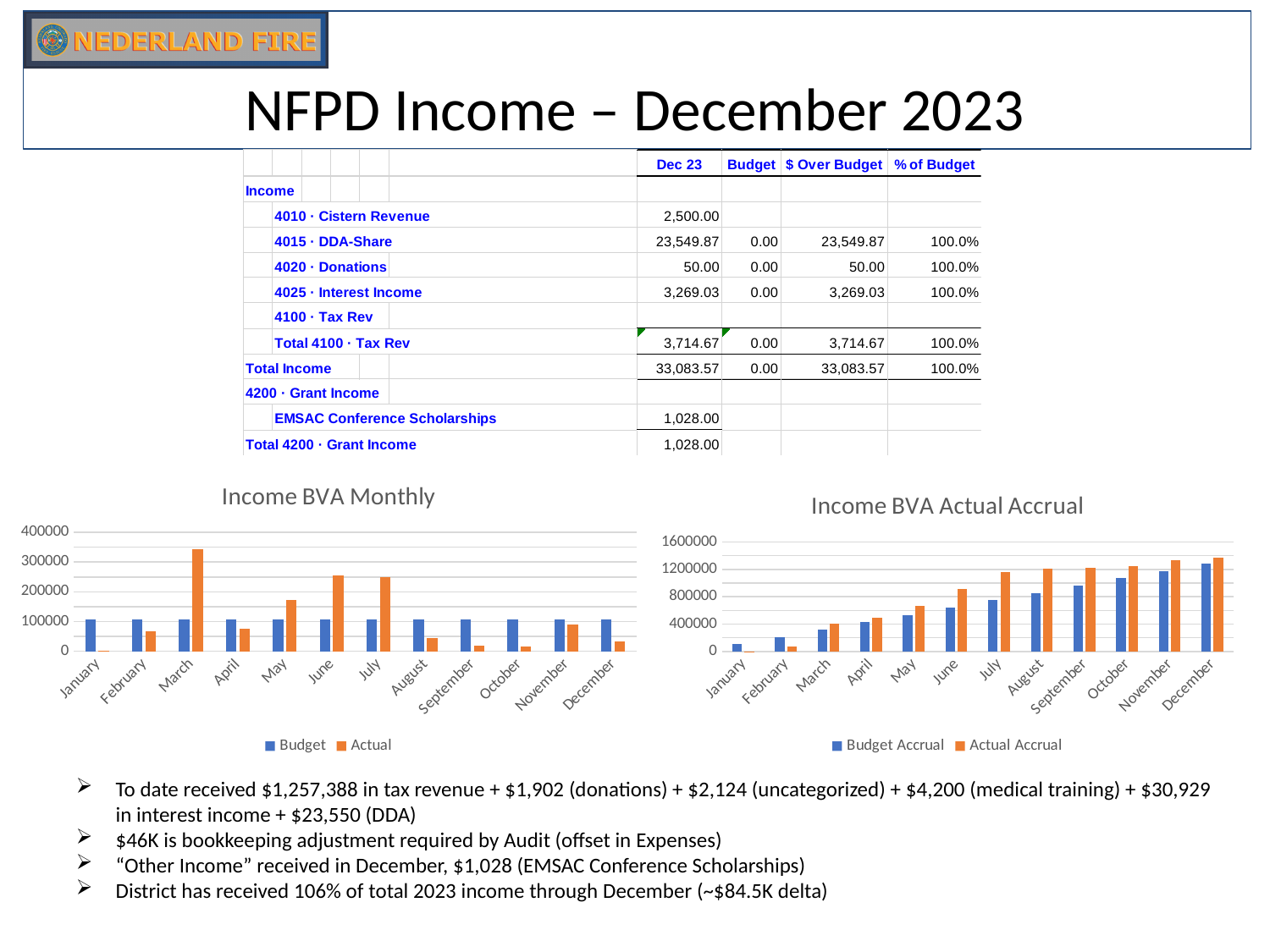
What are the two legend entries of the "Income BVA Actual Accrual" chart? Budget Accrual and Actual Accrual In the "Income BVA Monthly" chart, is the Actual value for September greater or less than 100000? less In the "Income BVA Actual Accrual" chart, do the Actual Accrual values rise or fall from January to December? Rise In the "Income BVA Monthly" chart, which month has the highest Actual value? March In the "Income BVA Monthly" chart, which is larger for June, Budget or Actual? Actual In the "Income BVA Monthly" chart, which is larger for August, Budget or Actual? Budget How many months are shown on the x axis of the "Income BVA Actual Accrual" chart? 12 How many series does the legend of the "Income BVA Monthly" chart list? 2 In the "Income BVA Actual Accrual" chart, which month has the highest Actual Accrual value? December In the "Income BVA Actual Accrual" chart, is the Actual Accrual value for December greater or less than 1200000? greater What kind of chart is the "Income BVA Monthly" chart? Bar chart In the "Income BVA Monthly" chart, is the Actual value for March greater or less than 300000? greater